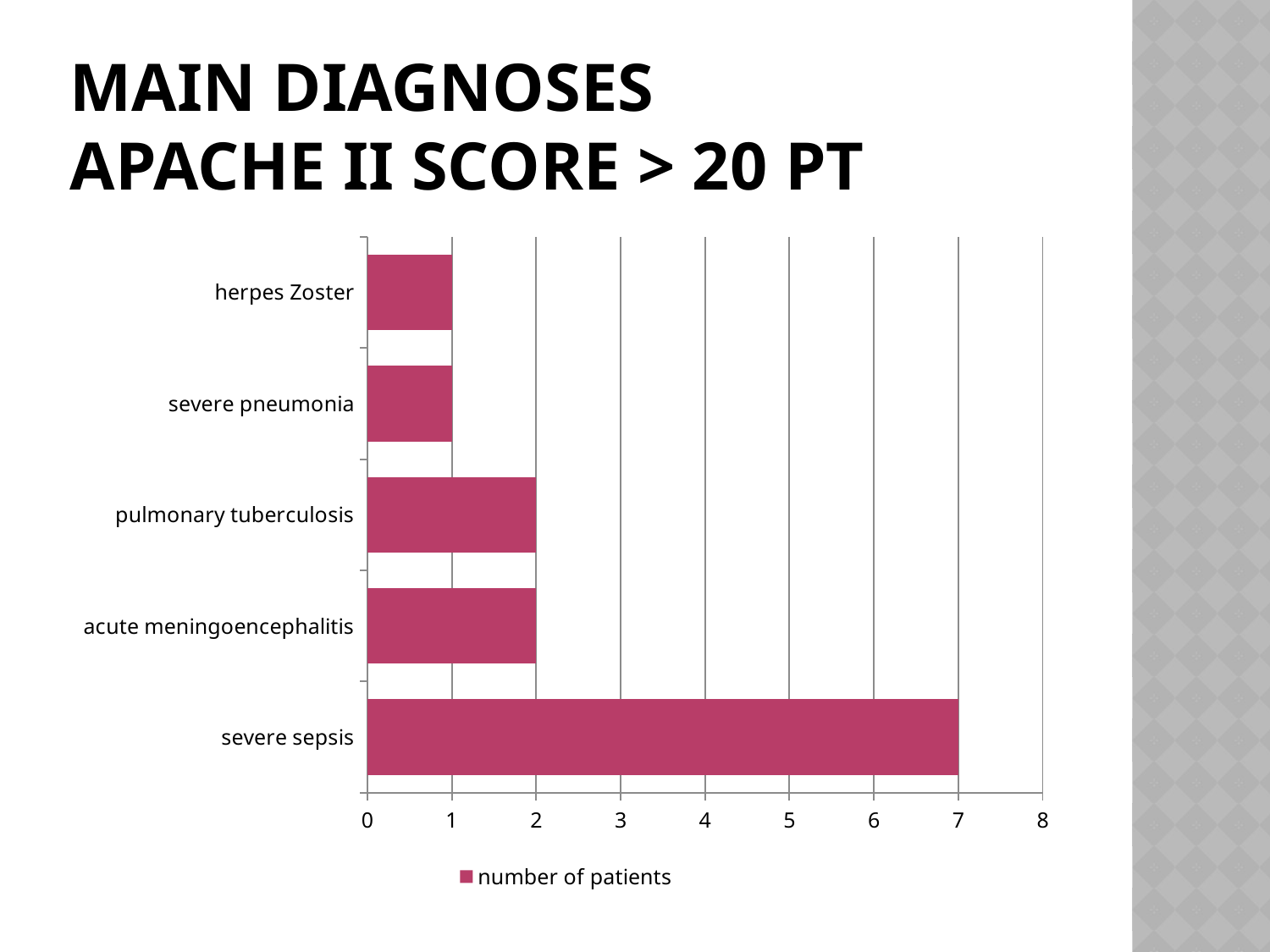
What is the number of patients for herpes Zoster? 1 Which diagnosis has the highest number of patients? severe sepsis What is the maximum value shown on the horizontal axis? 8 What is the number of patients for pulmonary tuberculosis? 2 How many diagnoses are shown on the chart? 5 What kind of chart is shown on the slide? bar chart What is the number of patients for severe sepsis? 7 Which has more patients, pulmonary tuberculosis or severe pneumonia? pulmonary tuberculosis How many series does the legend list? 1 Is the value for severe sepsis greater or less than 5? greater What is the legend entry for the series shown? number of patients What is the difference in number of patients between severe sepsis and acute meningoencephalitis? 5